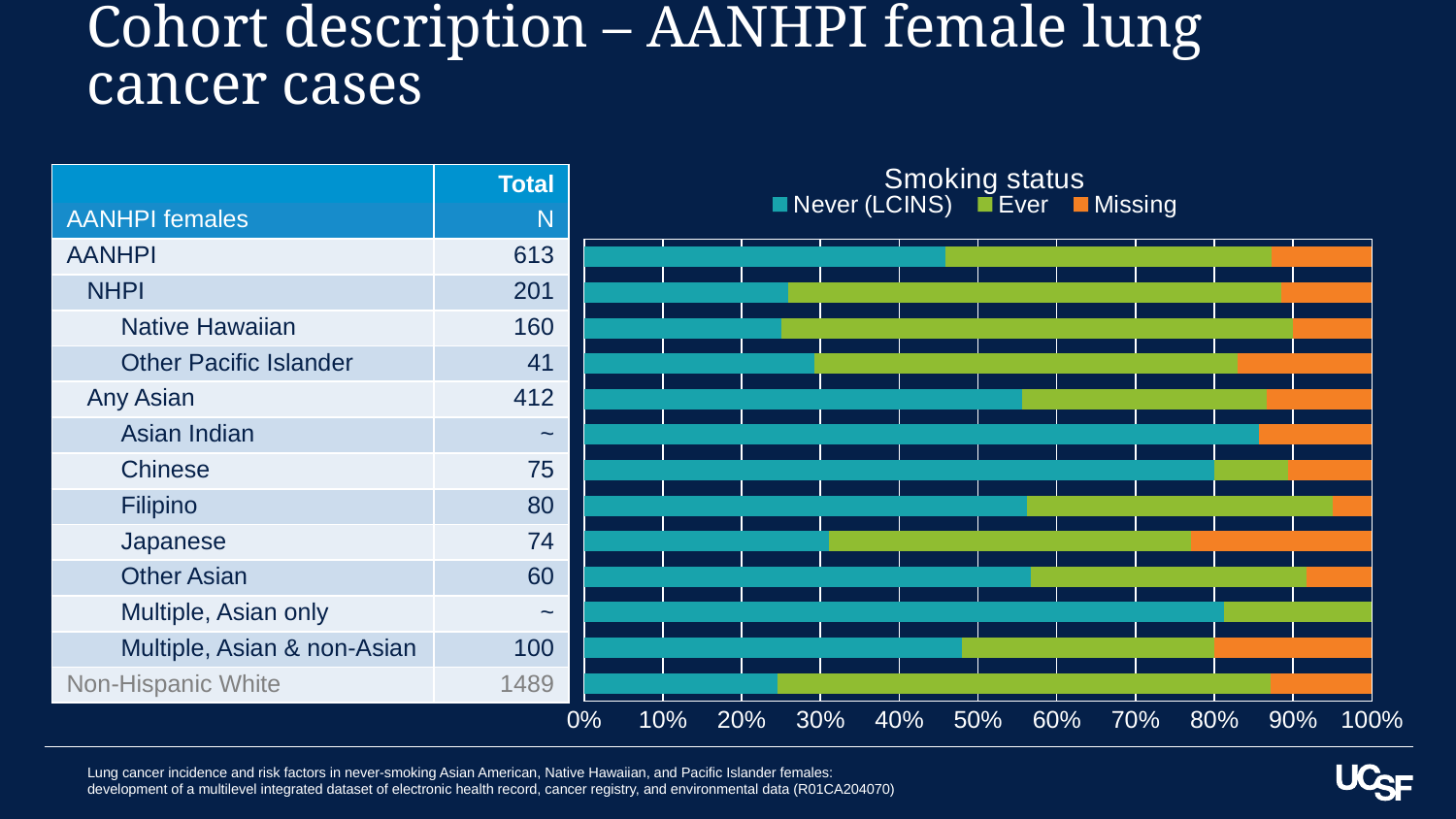
What are the three legend entries of the Smoking status chart? Never (LCINS), Ever, Missing Which has the larger Never (LCINS) share, AANHPI or NHPI? AANHPI What kind of chart is shown on the slide? Stacked bar chart How many bars (categories) are plotted in the Smoking status chart? 13 How many series does the legend of the Smoking status chart list? 3 Is the Never (LCINS) share for AANHPI greater or less than 40%? greater What is the title of the chart? Smoking status Is the Never (LCINS) share for Asian Indian greater or less than 80%? greater Which category has the largest Missing share in the Smoking status chart? Japanese Is the Never (LCINS) share for Native Hawaiian greater or less than 30%? less